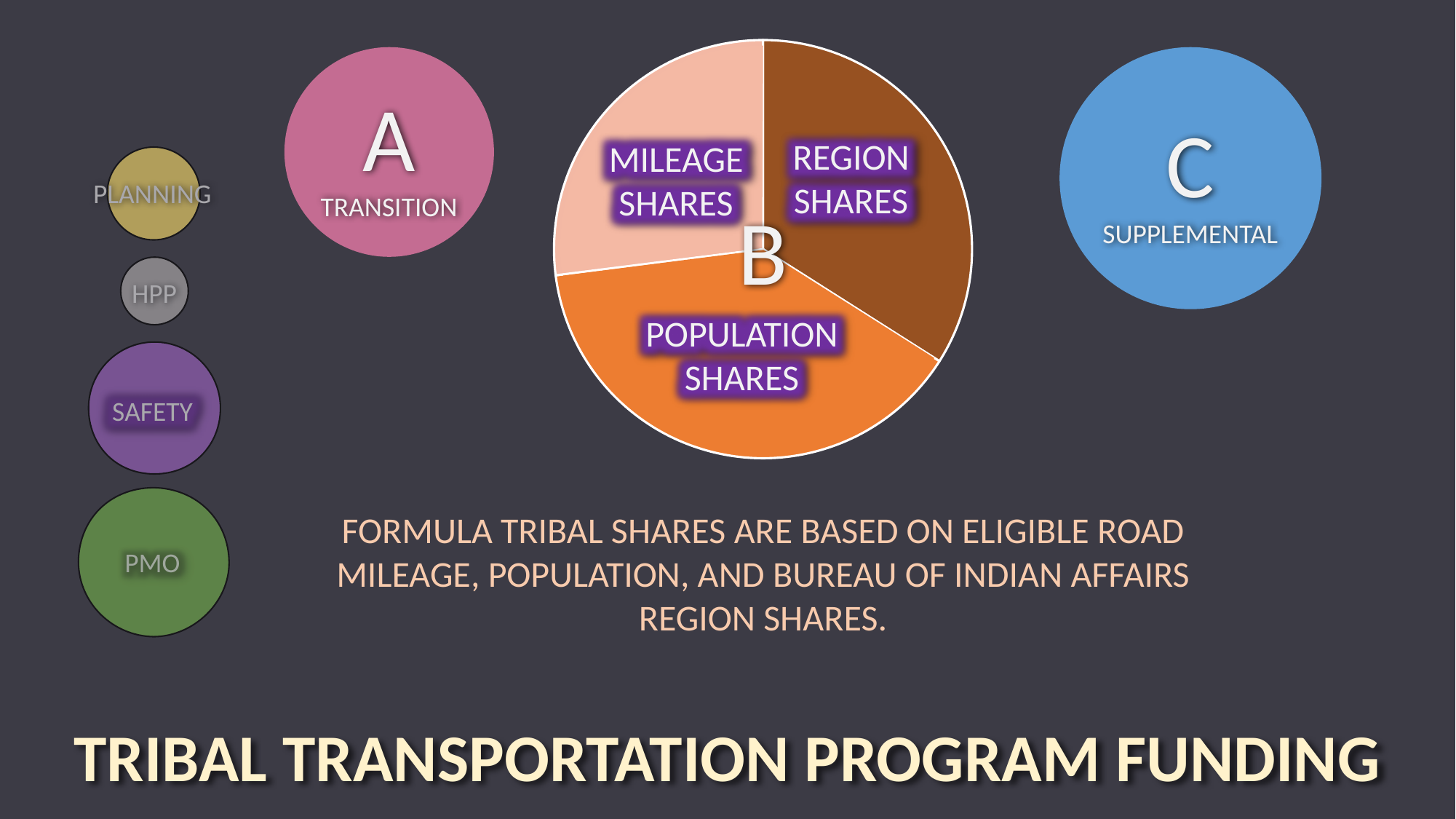
What kind of chart is shown in the middle of the slide? pie chart What letter is printed at the centre of the pie chart? B Which slice is larger in the pie chart, Mileage Shares or Population Shares? Population Shares Which slice of the pie chart is the smallest? Mileage Shares What colour is the Population Shares slice of the pie chart? orange Which slice is larger in the pie chart, Mileage Shares or Region Shares? Region Shares How many slices does the pie chart have? 3 Which slice of the pie chart is the largest? Population Shares